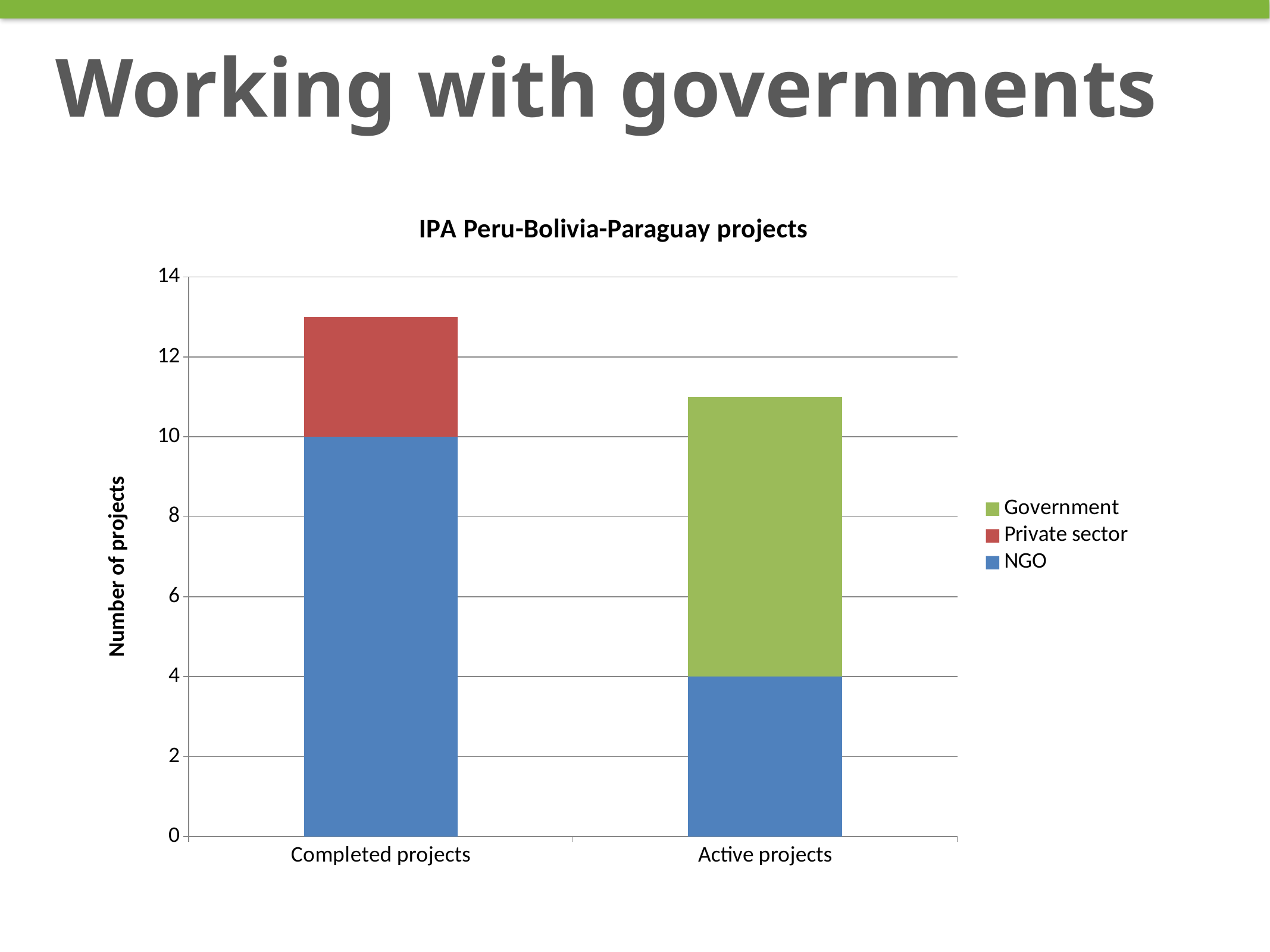
What is the title of the chart? IPA Peru-Bolivia-Paraguay projects Is the total for Active projects greater or less than 12? less How many series does the legend list? 3 Which is larger, the NGO value for Completed projects or the NGO value for Active projects? Completed projects How many categories are shown on the x axis? 2 What is the NGO value for Completed projects? 10 What is the difference between the NGO value for Completed projects and the NGO value for Active projects? 6 What is the NGO value for Active projects? 4 Which category has the taller stacked bar overall? Completed projects Is the total for Completed projects greater or less than 12? greater What is the label on the vertical axis? Number of projects What type of chart is shown on the slide? Stacked bar chart